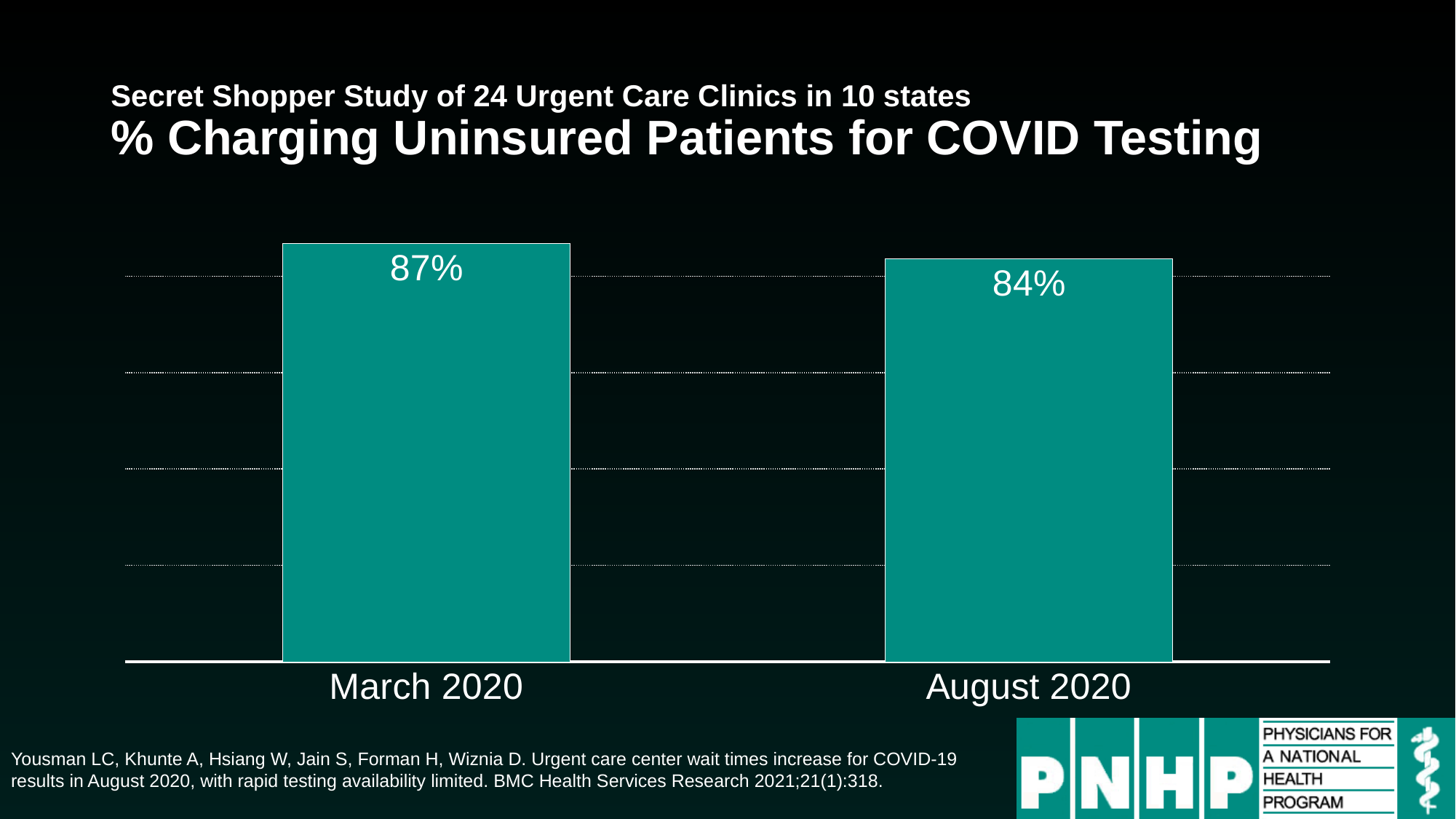
How many urgent care clinics were included in the secret shopper study, according to the chart's subtitle? 24 Does the percentage of clinics charging uninsured patients rise or fall from March 2020 to August 2020? fall Which month has the higher percentage of clinics charging uninsured patients for COVID testing? March 2020 By how many percentage points did the share of clinics charging uninsured patients fall from March 2020 to August 2020? 3 percentage points What is the title of the chart? % Charging Uninsured Patients for COVID Testing What percentage of urgent care clinics charged uninsured patients for COVID testing in March 2020? 87% What percentage of urgent care clinics charged uninsured patients for COVID testing in August 2020? 84% Which month has the lower percentage of clinics charging uninsured patients for COVID testing? August 2020 Is the value for March 2020 larger or smaller than the value for August 2020? larger What kind of chart is shown on the slide? bar chart How many categories are shown on the x axis of the chart? 2